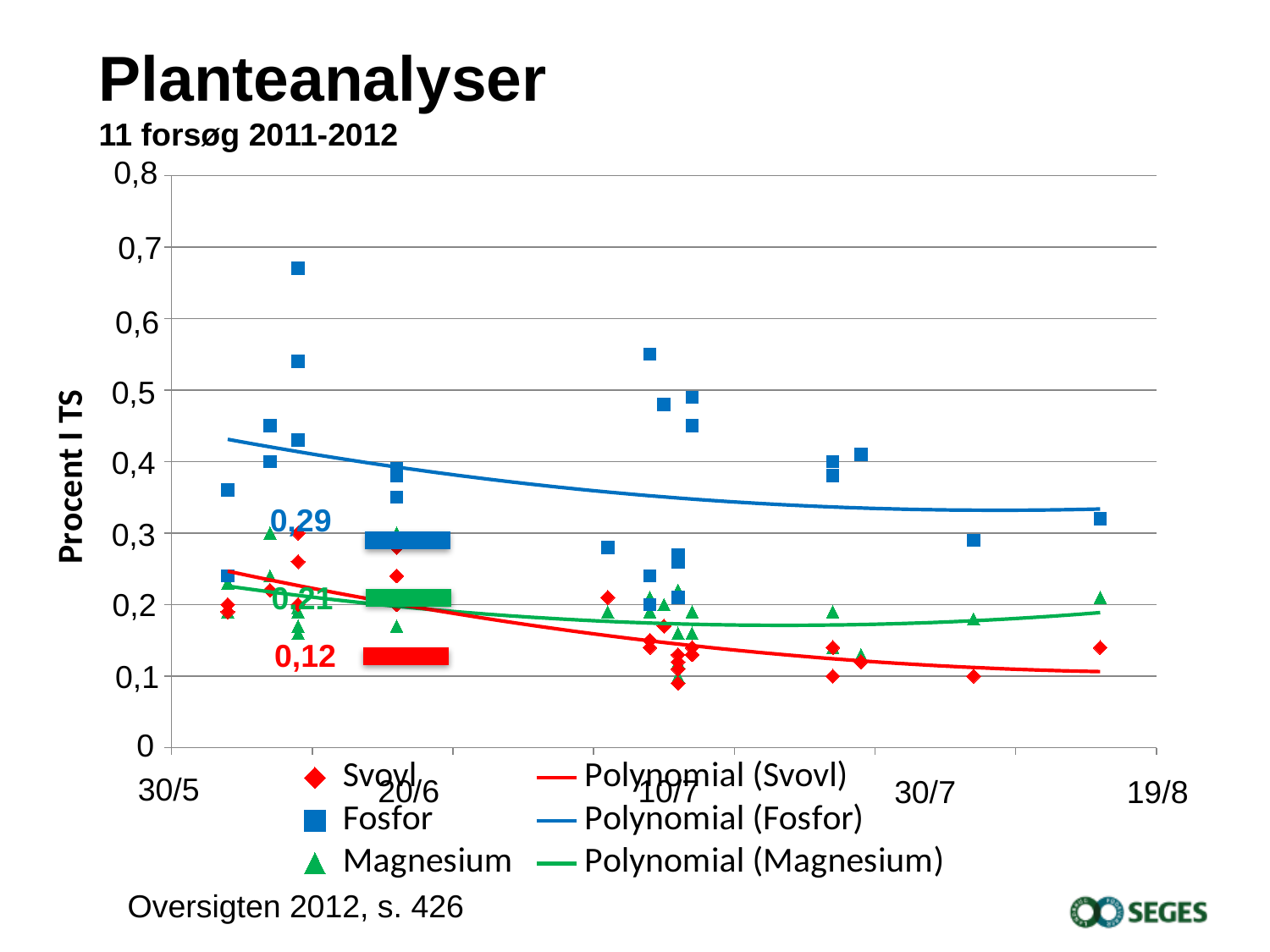
What value is printed next to the blue reference bar for Fosfor? 0,29 Which trend line lies higher on the chart, Polynomial (Fosfor) or Polynomial (Svovl)? Polynomial (Fosfor) Which of the three nutrient series has the highest plotted values overall? Fosfor What value is printed next to the green reference bar for Magnesium? 0,21 What kind of chart is shown on the slide? scatter chart Does the Polynomial (Fosfor) trend line rise or fall from left to right across the chart? fall What is the highest value shown on the vertical axis? 0,8 What value is printed next to the red reference bar for Svovl? 0,12 Does the Polynomial (Svovl) trend line rise or fall from left to right across the chart? fall What is the title of the chart's vertical axis? Procent I TS How many entries does the chart legend list? 6 Is the highest Fosfor data point greater or less than 0,6? greater